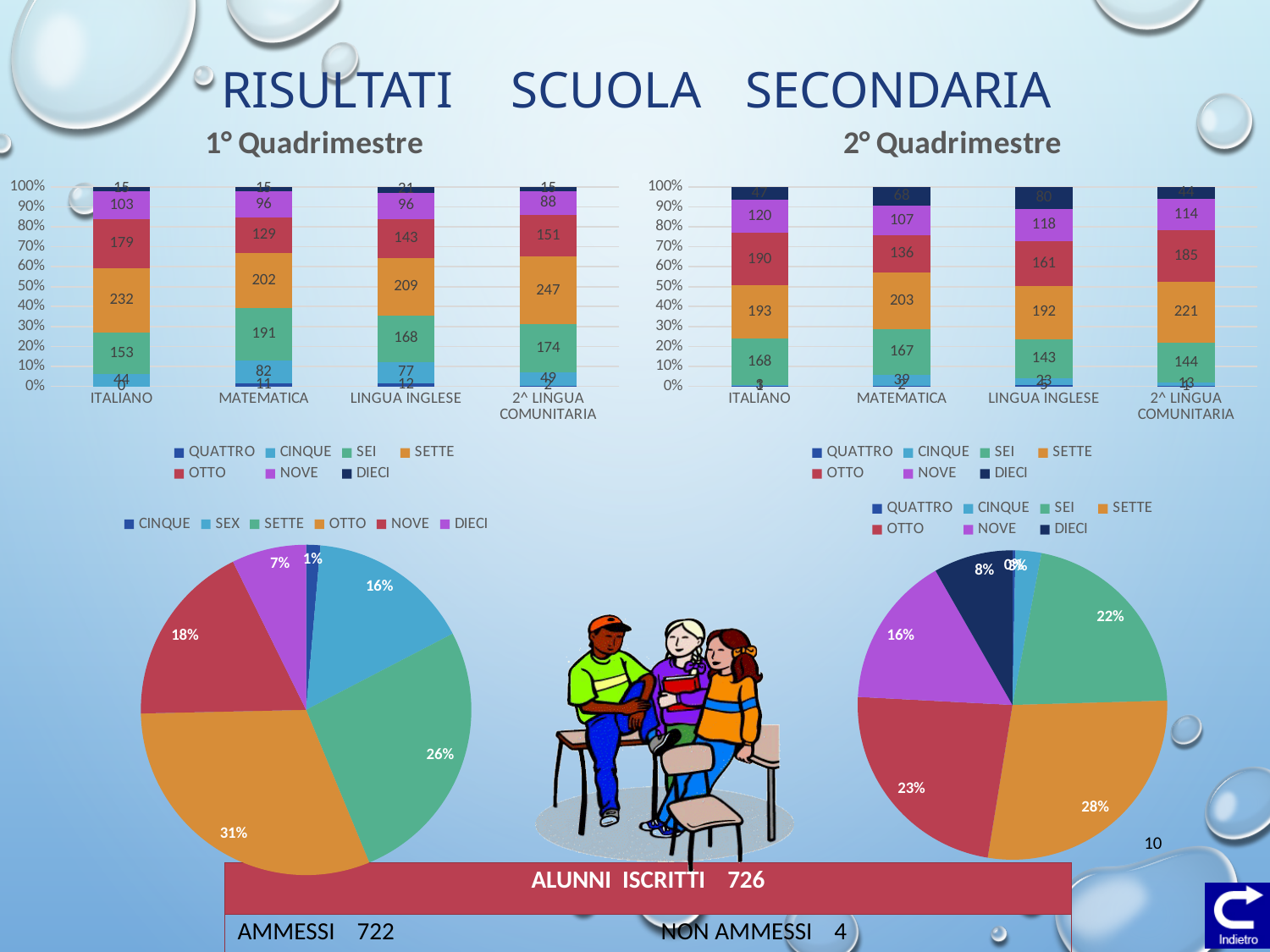
In the 1° Quadrimestre chart, what is the difference between the SETTE values for ITALIANO and MATEMATICA? 30 In the 2° Quadrimestre chart, which has the larger OTTO value, ITALIANO or MATEMATICA? ITALIANO How many entries does the legend of the bottom-left pie chart list? 6 In the bottom-left pie chart, what share does the OTTO slice have? 31% In the 1° Quadrimestre chart, what is the value for SETTE in ITALIANO? 232 How many categories are shown on the x axis of the 1° Quadrimestre chart? 4 In the 2° Quadrimestre chart, what is the value for SETTE in 2^ LINGUA COMUNITARIA? 221 What kind of chart is the 1° Quadrimestre chart? Stacked bar chart How many series does the legend of the 2° Quadrimestre chart list? 7 In the 2° Quadrimestre chart, what is the value for NOVE in ITALIANO? 120 In the 1° Quadrimestre chart, what is the value for OTTO in 2^ LINGUA COMUNITARIA? 151 In the bottom-right pie chart, which slice is the largest? SETTE (28%)